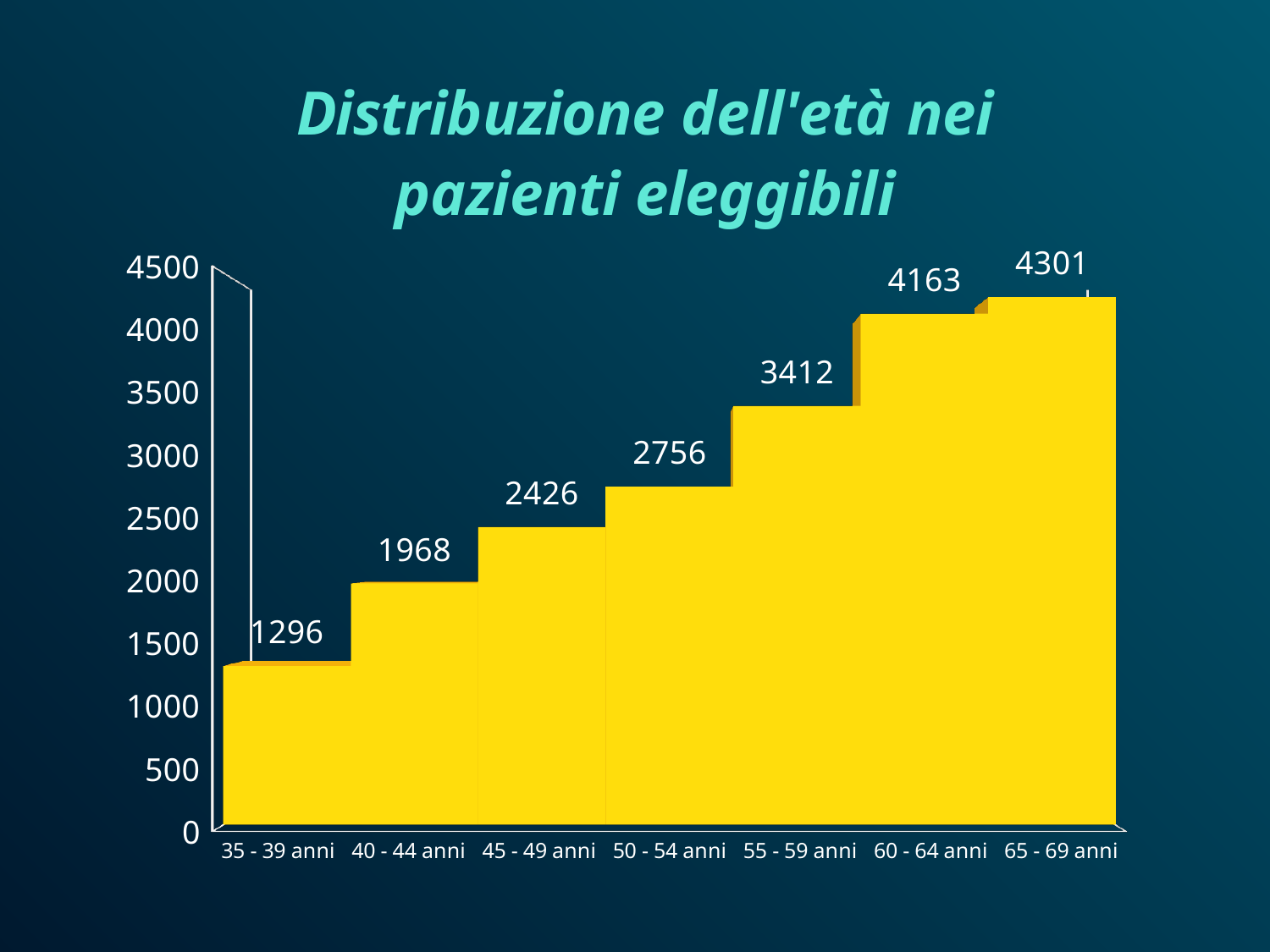
Which age group has the highest value? 65 - 69 anni Which is larger, the value for 40 - 44 anni or the value for 45 - 49 anni? 45 - 49 anni How many age groups are shown on the x axis? 7 What is the value for the 50 - 54 anni age group? 2756 What is the value for the 60 - 64 anni age group? 4163 What is the value for the 35 - 39 anni age group? 1296 Which age group has the lowest value? 35 - 39 anni What is the difference between the values for 65 - 69 anni and 60 - 64 anni? 138 Do the values rise or fall as the age groups increase along the x axis? rise Is the value for 55 - 59 anni greater or less than 3000? greater What is the difference between the values for 55 - 59 anni and 50 - 54 anni? 656 What is the title of the chart? Distribuzione dell'età nei pazienti eleggibili